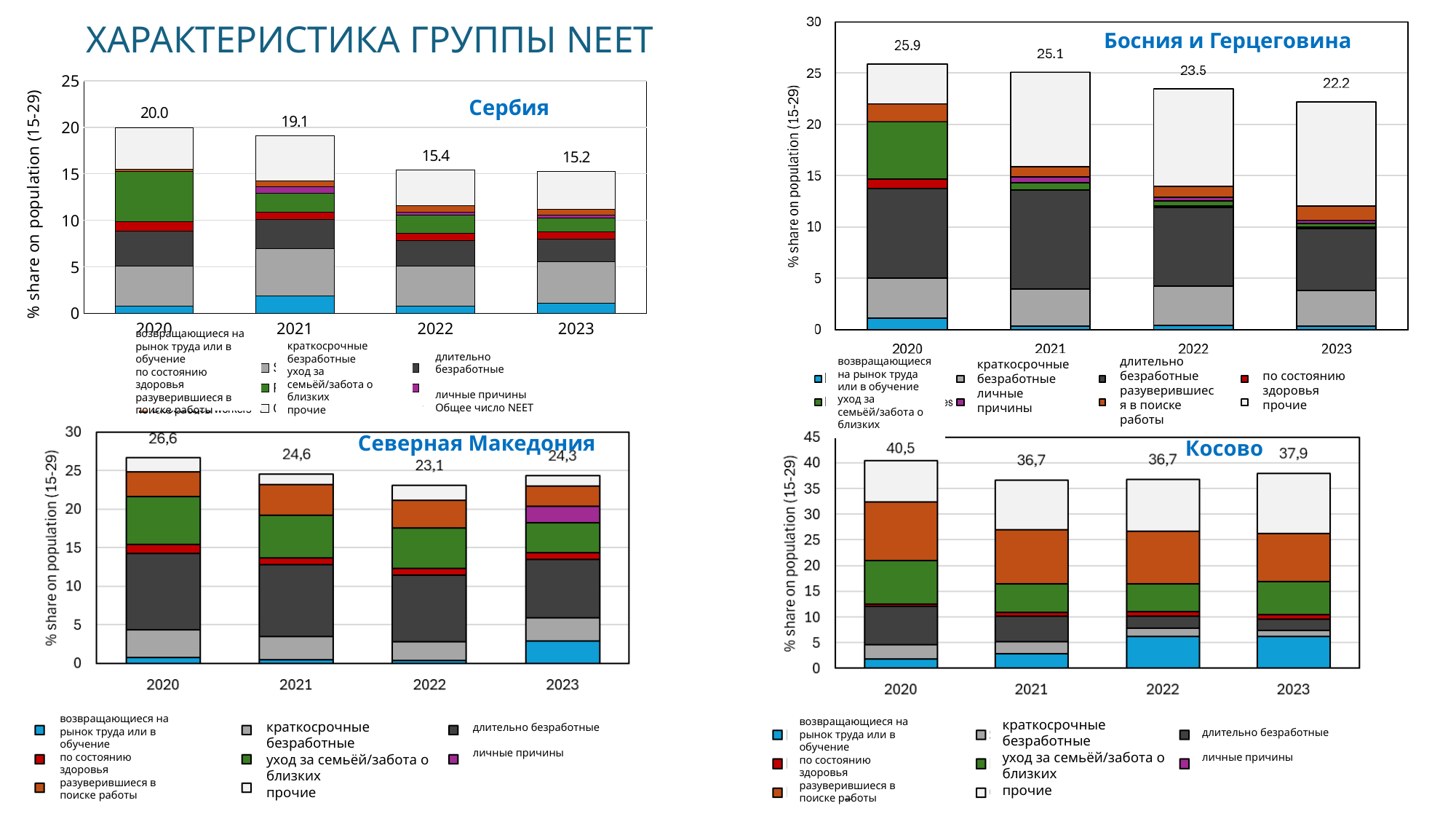
In the Сербия chart, what is the total NEET share labelled for 2020? 20.0 In the Сербия chart, do the totals rise or fall from 2020 to 2023? fall What kind of chart is the Северная Македония chart? stacked bar chart In the Босния и Герцеговина chart, what is the total labelled for 2023? 22.2 How many years are shown on the x axis of the Босния и Герцеговина chart? 4 In the Сербия chart, what is the difference between the 2020 total and the 2023 total? 4.8 In the Босния и Герцеговина chart, what is the difference between the 2020 and 2023 totals? 3.7 In the Северная Македония chart, which total is larger, 2021 or 2023? 2021 In the Северная Македония chart, which year has the lowest total? 2022 In the Косово chart, which year has the highest total? 2020 In the Косово chart, is the total for 2023 greater or less than 35? greater In the Косово chart, what is the total labelled for 2020? 40,5